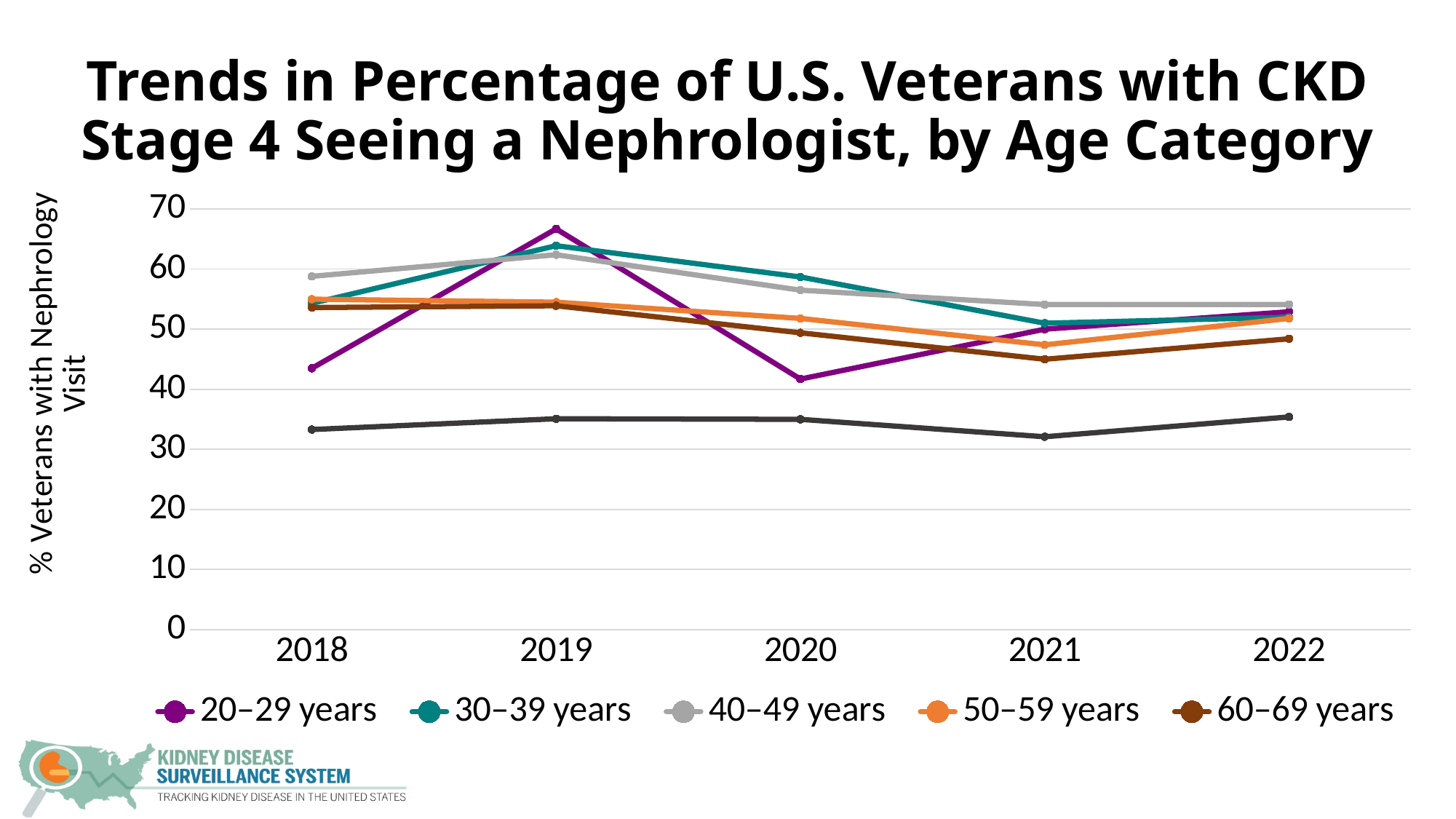
What is the label on the y axis? % Veterans with Nephrology Visit Is the value for 20–29 years in 2020 greater or less than 50? less Which age category has the highest value in 2018? 40–49 years Does the value for 60–69 years rise or fall from 2019 to 2021? fall Which age category has the highest value in 2019? 20–29 years How many age categories does the legend list? 5 What kind of chart is shown on the slide? line chart How many years are shown along the x axis? 5 Is the value for 20–29 years in 2019 greater or less than 60? greater Is the value for 40–49 years in 2022 greater or less than 50? greater Among the age categories listed in the legend, which has the lowest value in 2020? 20–29 years In 2018, which is larger: the value for 20–29 years or the value for 40–49 years? 40–49 years